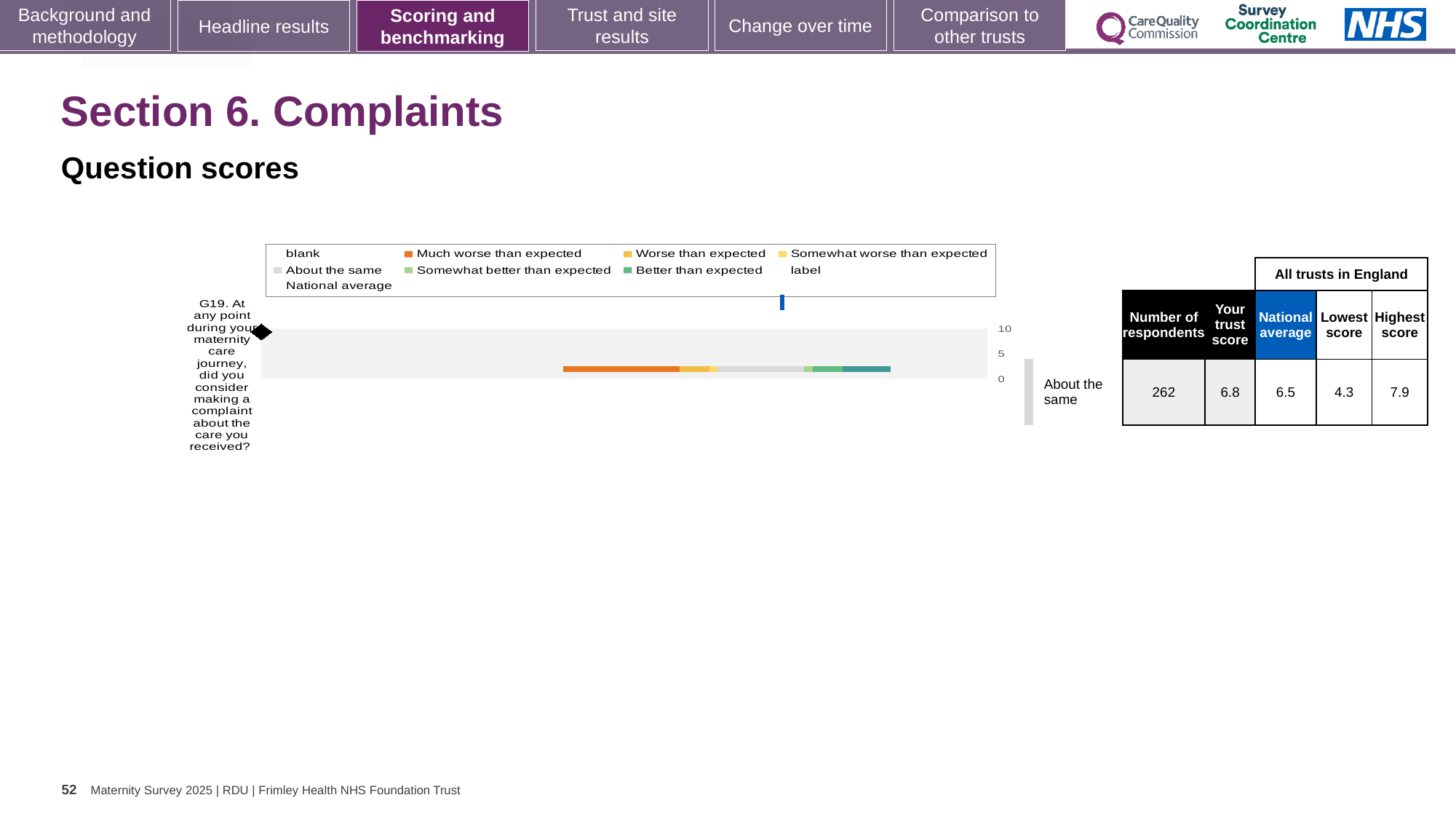
How many questions (categories) are plotted on the chart? 1 Which question is plotted on the chart? G19. At any point during your maternity care journey, did you consider making a complaint about the care you received? What is the difference between the highest score and the lowest score for question G19? 3.6 In the table beside the chart, what is the highest score among all trusts in England for question G19? 7.9 What colour is the 'Much worse than expected' segment in the chart legend? orange In the table beside the chart, what is the trust score for question G19? 6.8 Is the trust score for question G19 larger or smaller than the national average? larger What rating label is shown next to the bar for question G19? About the same In the table beside the chart, what is the lowest score among all trusts in England for question G19? 4.3 In the table beside the chart, what is the number of respondents for question G19? 262 What kind of chart is shown on the slide? bar chart In the table beside the chart, what is the national average for question G19? 6.5